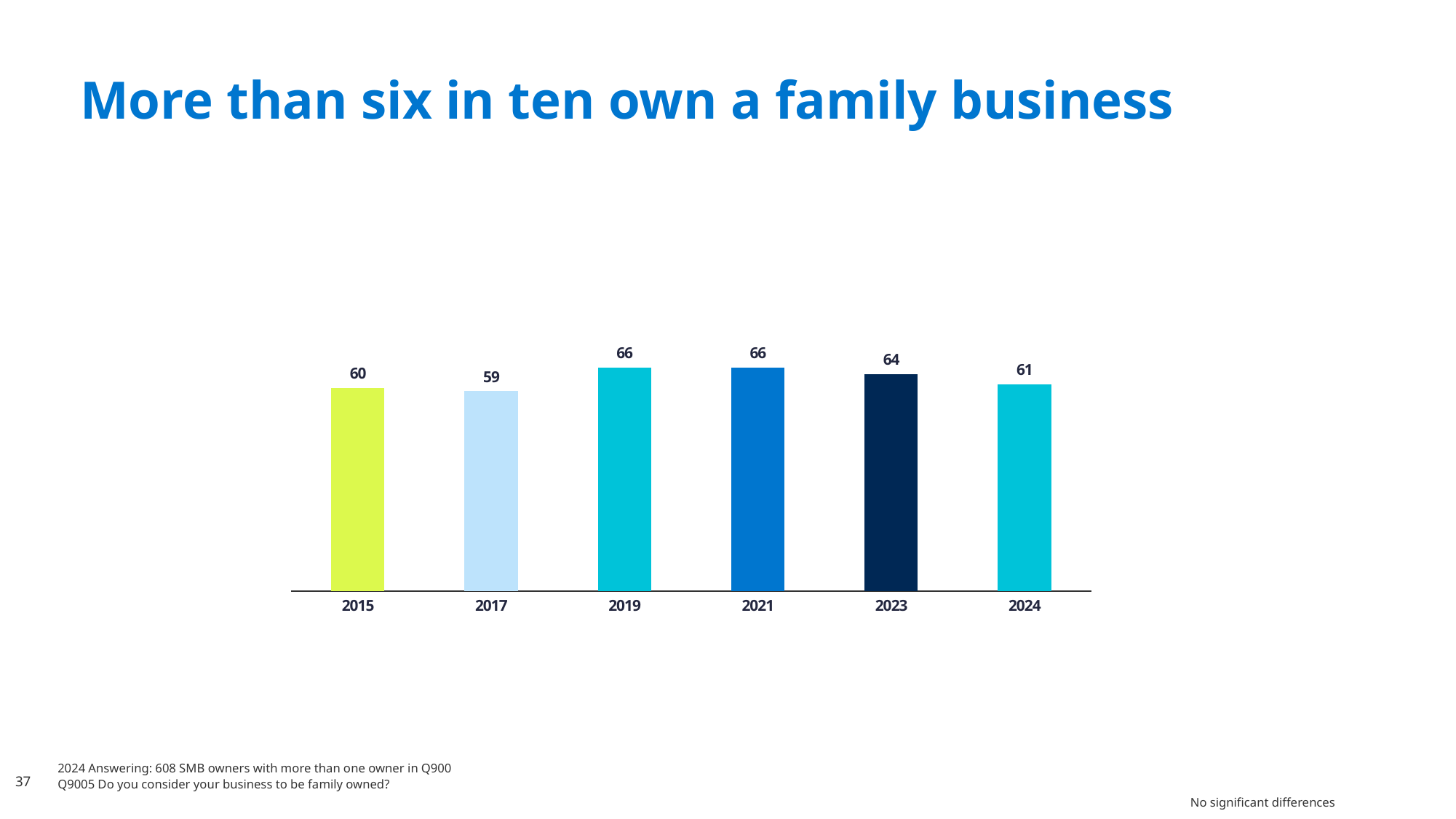
What is the value for 2015? 60 What is the value for 2017? 59 What is the difference between the values for 2023 and 2017? 5 What is the value for 2024? 61 What is the value for 2023? 64 What kind of chart is shown on the slide? Bar chart Which is larger, the value for 2021 or the value for 2024? 2021 Which year has the lowest value? 2017 What is the difference between the values for 2019 and 2024? 5 Do the values rise or fall from 2021 to 2024? Fall How many years are shown on the chart? 6 What is the title of the slide? More than six in ten own a family business